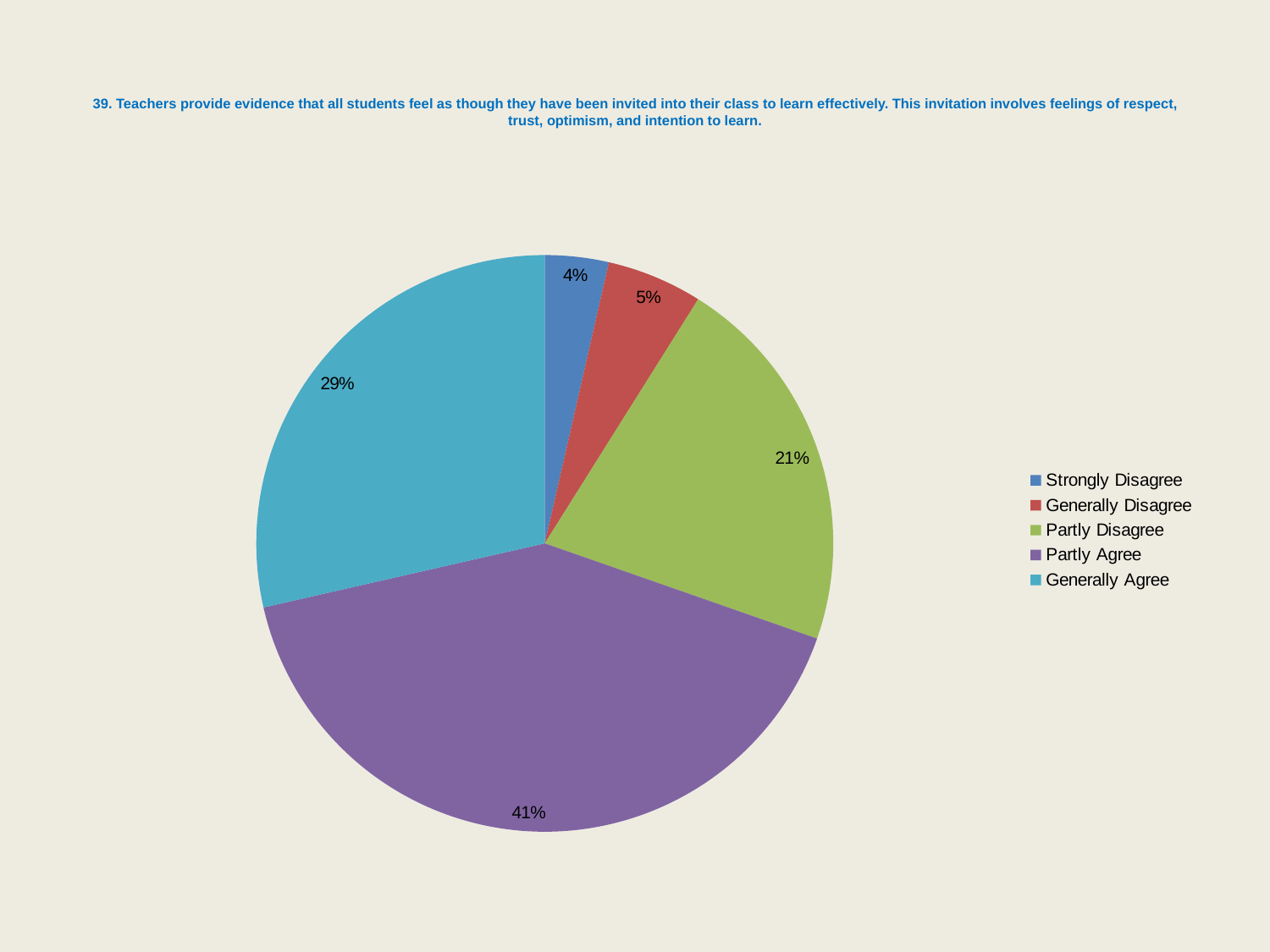
Which is larger, the share for Partly Disagree or the share for Generally Disagree? Partly Disagree What percentage of responses are Partly Disagree? 21% What is the difference in percentage points between Partly Agree and Generally Agree? 12 What percentage of responses are Partly Agree? 41% Which response category has the largest share of the pie? Partly Agree What percentage of responses are Strongly Disagree? 4% What kind of chart is shown on the slide? pie chart What percentage of responses are Generally Agree? 29% What colour is the Partly Agree slice? purple What percentage of responses are Generally Disagree? 5% How many categories does the legend list? 5 Which response category has the smallest share of the pie? Strongly Disagree